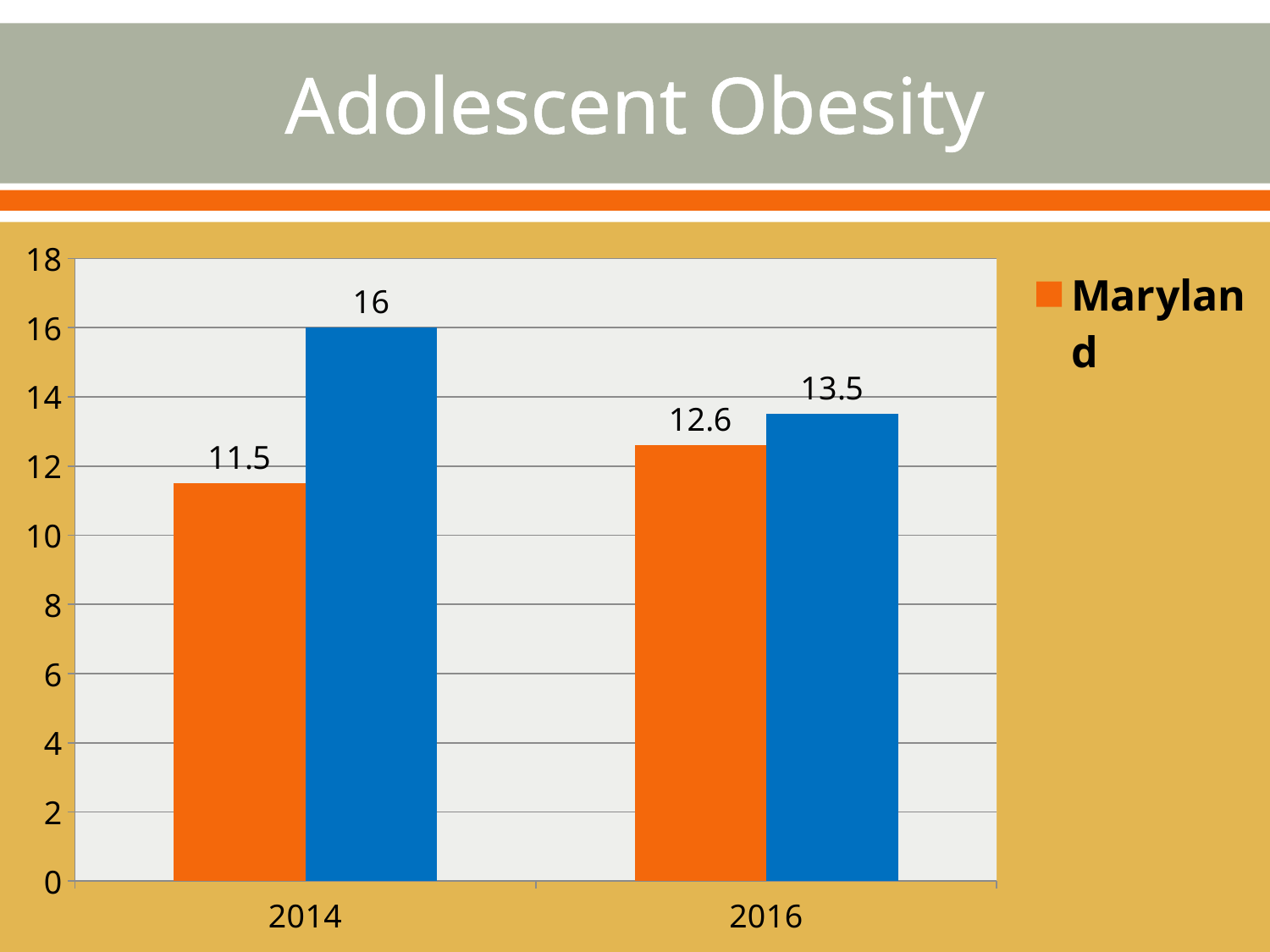
What is the value of the blue bar for 2014? 16 In which year is the Maryland value higher? 2016 How many years are shown on the x axis? 2 What is the value for Maryland in 2014? 11.5 What is the value of the blue bar for 2016? 13.5 Does the Maryland value rise or fall from 2014 to 2016? Rise What is the difference between the blue bar and the Maryland bar in 2014? 4.5 By how much did the Maryland value change from 2014 to 2016? 1.1 Does the blue series rise or fall from 2014 to 2016? Fall What type of chart is shown on the slide? Bar chart In 2016, which is larger: the Maryland bar or the blue bar? The blue bar What is the value for Maryland in 2016? 12.6